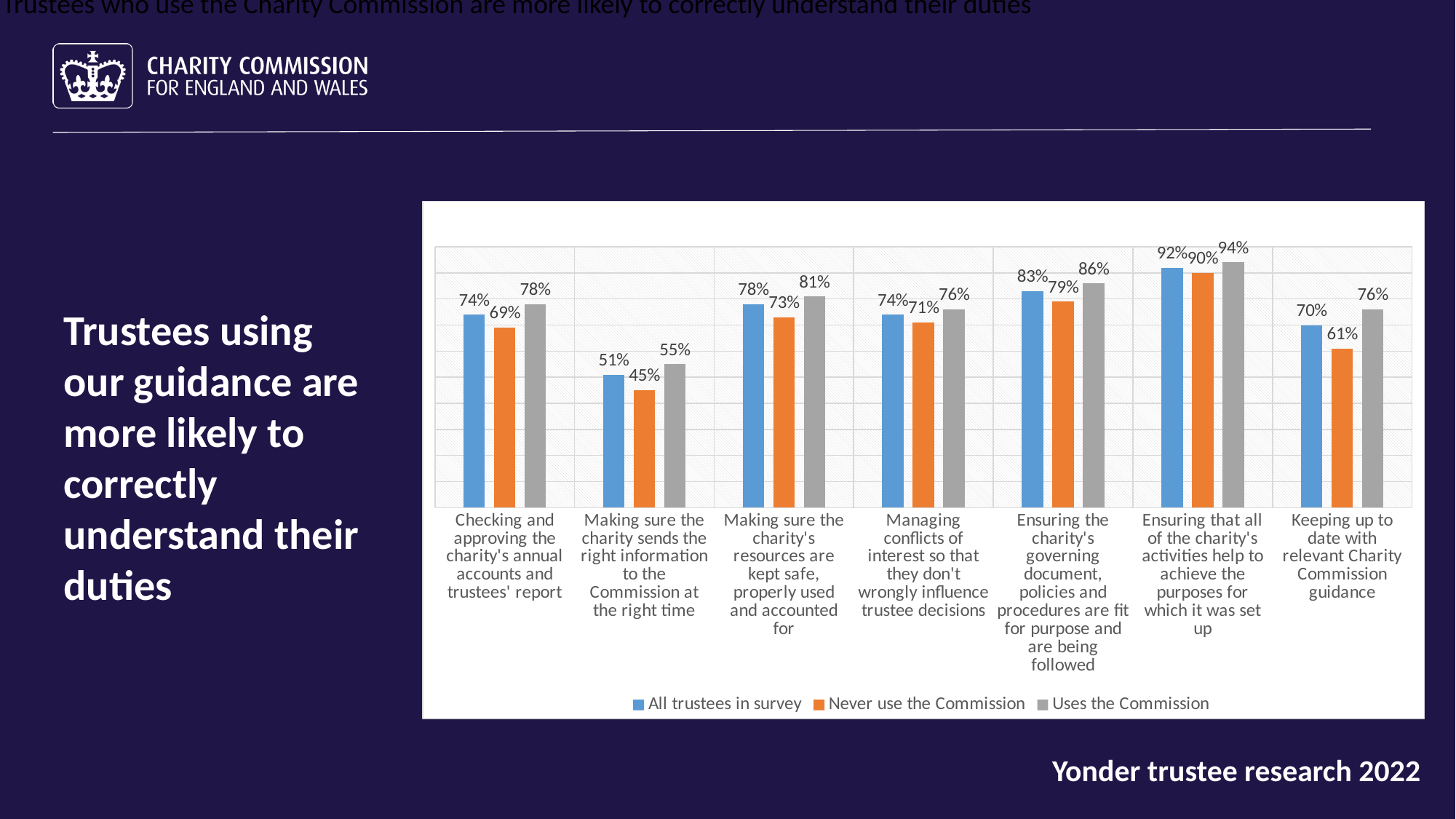
For managing conflicts of interest, which is larger: the value for 'All trustees in survey' or for 'Never use the Commission'? All trustees in survey What is the value for 'Uses the Commission' for keeping up to date with relevant Charity Commission guidance? 76% How many series does the chart legend list? 3 What kind of chart is shown on the slide? Bar chart How many duties (categories) are shown on the x axis of the chart? 7 Which colour represents the 'Never use the Commission' series in the chart? Orange What is the difference between 'Uses the Commission' and 'Never use the Commission' for keeping up to date with relevant Charity Commission guidance? 15% What is the value for 'All trustees in survey' for ensuring the charity's governing document, policies and procedures are fit for purpose and are being followed? 83% What percentage of trustees who never use the Commission correctly understand the duty of making sure the charity sends the right information to the Commission at the right time? 45% Which duty has the lowest value for the 'Never use the Commission' series? Making sure the charity sends the right information to the Commission at the right time What is the difference between 'Uses the Commission' and 'Never use the Commission' for checking and approving the charity's annual accounts and trustees' report? 9% Which duty has the highest value for the 'Uses the Commission' series? Ensuring that all of the charity's activities help to achieve the purposes for which it was set up